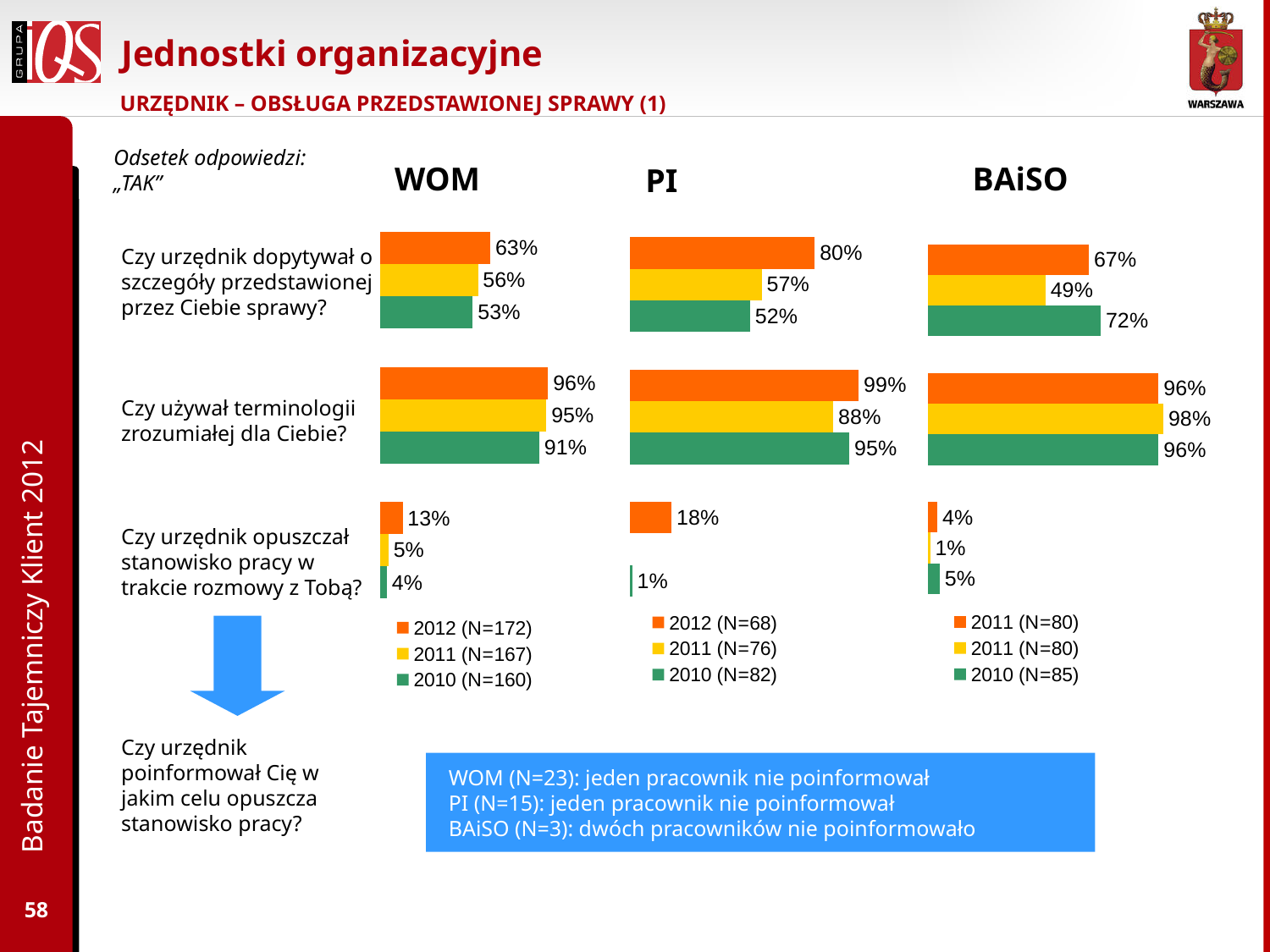
What type of chart is used for the WOM, PI and BAiSO data? Bar chart In the PI chart, what is the 2012 value for "Czy urzędnik opuszczał stanowisko pracy w trakcie rozmowy z Tobą?"? 18% In the BAiSO chart, which year has the lowest value for "Czy urzędnik dopytywał o szczegóły przedstawionej przez Ciebie sprawy?"? 2011 In the WOM chart, what is the difference between the 2012 and 2011 values for "Czy urzędnik opuszczał stanowisko pracy w trakcie rozmowy z Tobą?"? 8 percentage points For "Czy używał terminologii zrozumiałej dla Ciebie?" in 2012, which is larger: the WOM value or the PI value? PI In the WOM chart, which year has the highest value for "Czy urzędnik opuszczał stanowisko pracy w trakcie rozmowy z Tobą?"? 2012 In the BAiSO chart, what is the 2010 value for "Czy urzędnik dopytywał o szczegóły przedstawionej przez Ciebie sprawy?"? 72% In the PI chart, what is the 2011 value for "Czy używał terminologii zrozumiałej dla Ciebie?"? 88% In the PI chart, what is the difference between the 2012 and 2010 values for "Czy urzędnik dopytywał o szczegóły przedstawionej przez Ciebie sprawy?"? 28 percentage points How many series does the legend of the WOM chart list? 3 What is the sample size (N) for 2010 in the PI chart legend? 82 In the WOM chart, what percentage of 2012 respondents said the clerk asked about details of the presented matter ("Czy urzędnik dopytywał o szczegóły przedstawionej przez Ciebie sprawy?")? 63%